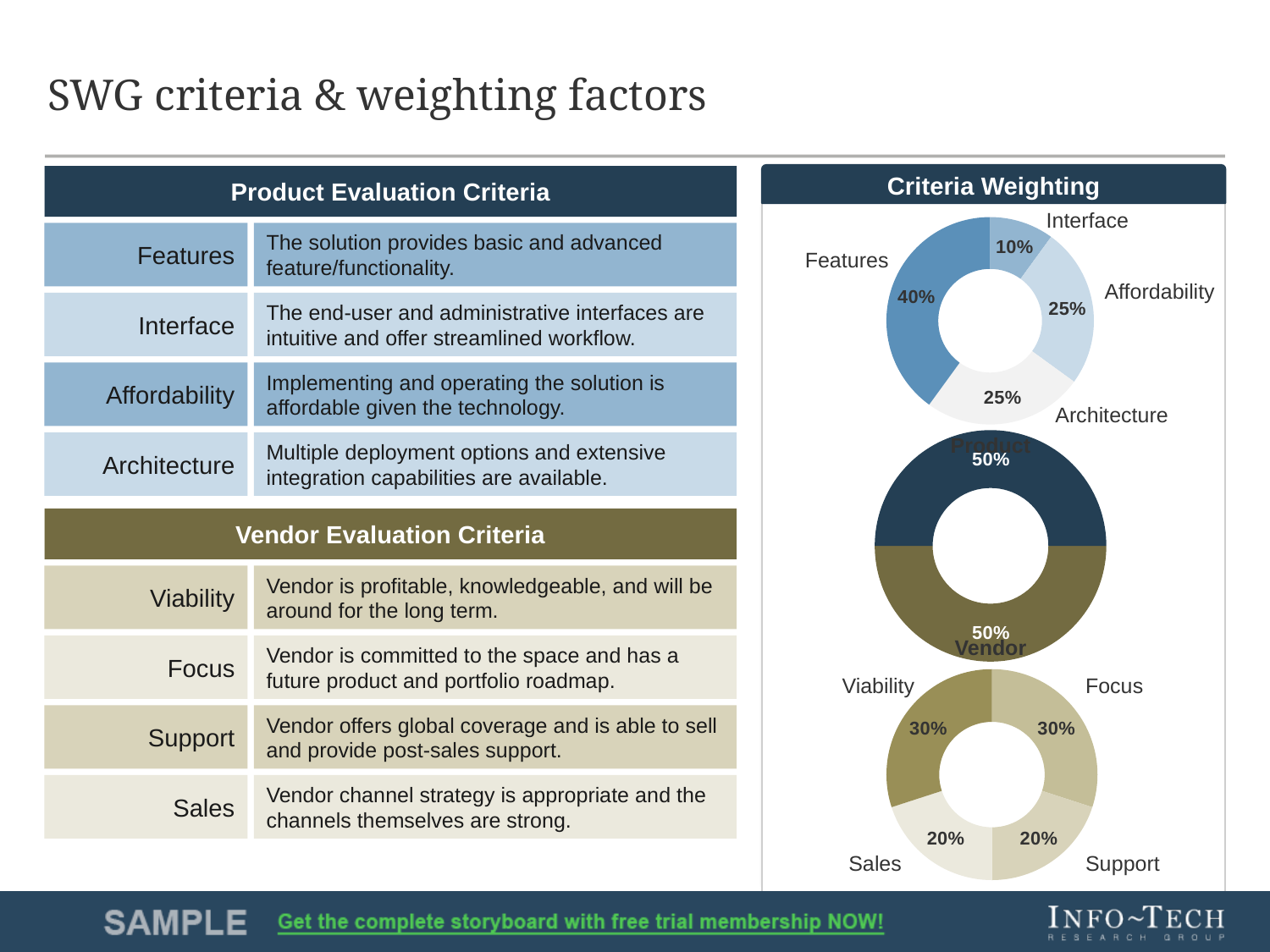
In the bottom donut chart under Criteria Weighting, which is larger, the weighting for Viability or the weighting for Sales? Viability In the top donut chart under Criteria Weighting, which criterion has the lowest weighting? Interface In the top donut chart under Criteria Weighting, what is the weighting for Interface? 10% How many donut charts are shown under the Criteria Weighting heading? 3 In the middle donut chart under Criteria Weighting, what is the weighting for Vendor? 50% What type of chart is used to show the criteria weightings on the slide? Donut chart In the middle donut chart under Criteria Weighting, how many segments are shown? 2 In the top donut chart under Criteria Weighting, which criterion has the highest weighting? Features In the bottom donut chart under Criteria Weighting, what is the weighting for Support? 20% In the bottom donut chart under Criteria Weighting, what is the difference between the Focus and Support weightings? 10% In the top donut chart under Criteria Weighting, what is the difference between the Features and Affordability weightings? 15% In the top donut chart under Criteria Weighting, what is the weighting for Features? 40%